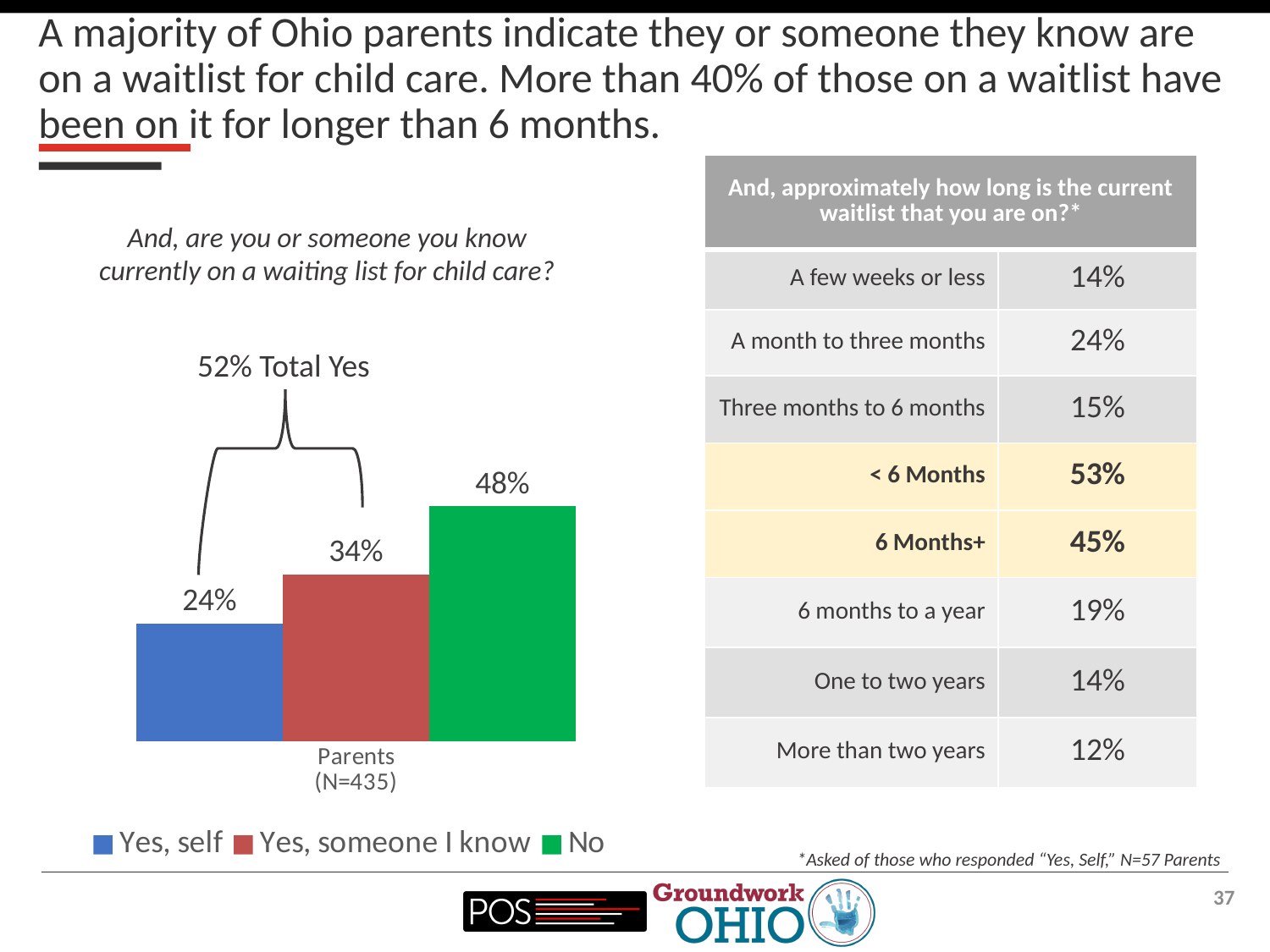
How many series does the legend of the bar chart list? 3 What is the sample size (N) shown for Parents under the bar chart? 435 What is the difference in percentage points between "No" and "Yes, self"? 24 What type of chart is shown on the left of the slide? Bar chart Which is larger: the percentage for "Yes, someone I know" or for "Yes, self"? Yes, someone I know Which response has the highest percentage in the bar chart? No What is the combined "Total Yes" percentage shown above the bars? 52% What percentage of parents answered "Yes, self" to being on a child care waiting list? 24% What colour is the bar for "No" in the chart? Green Which response has the lowest percentage in the bar chart? Yes, self What percentage of parents answered "No" to being on a waiting list? 48% What percentage of parents answered "Yes, someone I know"? 34%